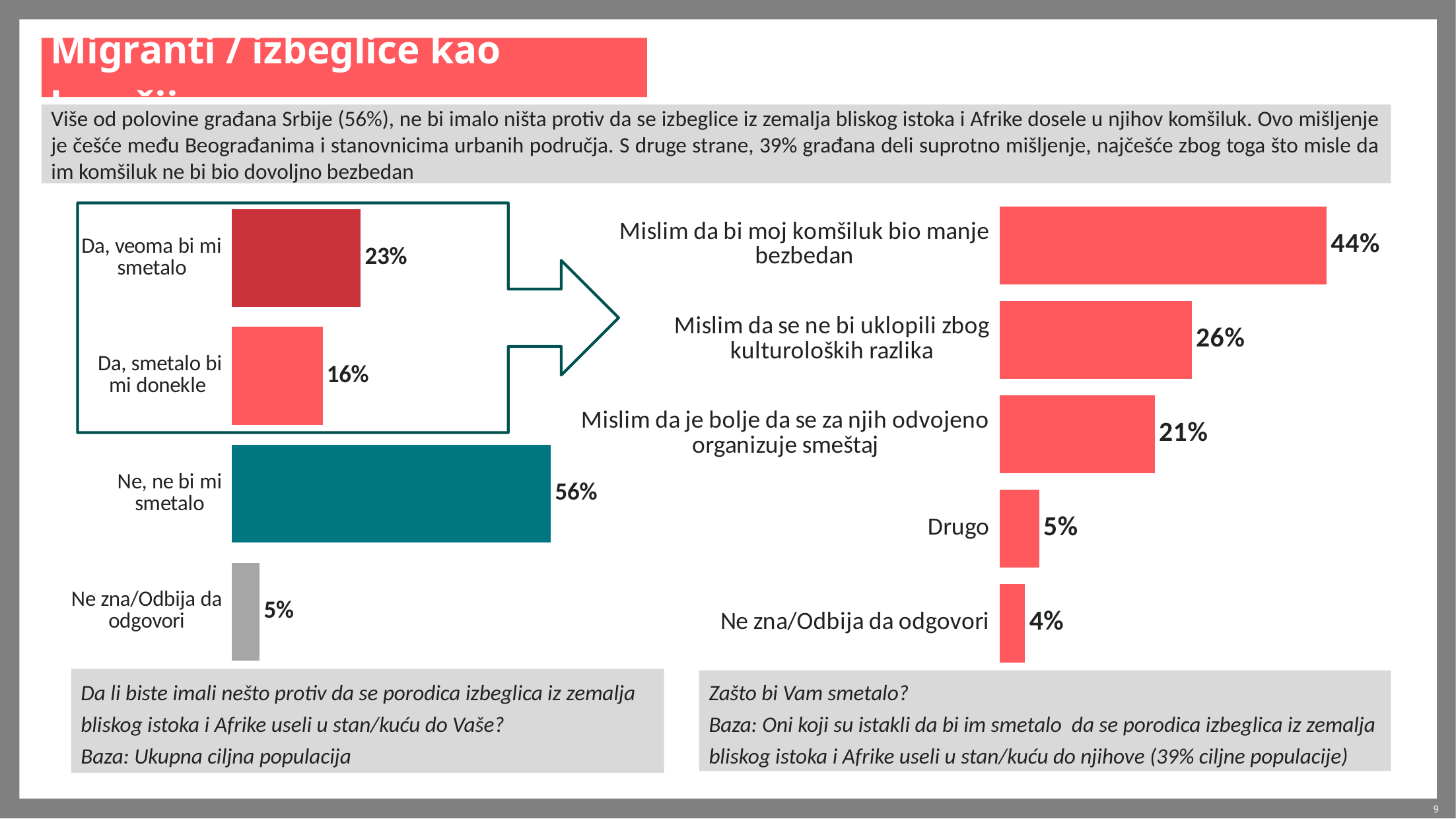
In the left chart, what is the difference between "Da, veoma bi mi smetalo" and "Da, smetalo bi mi donekle"? 7% In the left chart, what percentage of respondents answered "Ne, ne bi mi smetalo"? 56% In the right chart, which category has the lowest value? Ne zna/Odbija da odgovori In the right chart, what percentage chose "Mislim da je bolje da se za njih odvojeno organizuje smeštaj"? 21% What type of chart is the right chart? Bar chart In the left chart, how many categories are shown? 4 In the right chart, how many categories are shown? 5 In the left chart, what is the value for "Da, veoma bi mi smetalo"? 23% In the left chart, which category has the highest value? Ne, ne bi mi smetalo In the right chart, what is the value for "Mislim da bi moj komšiluk bio manje bezbedan"? 44% In the right chart, what is the difference between "Mislim da bi moj komšiluk bio manje bezbedan" and "Mislim da se ne bi uklopili zbog kulturoloških razlika"? 18% In the right chart, which is larger: "Mislim da se ne bi uklopili zbog kulturoloških razlika" or "Drugo"? Mislim da se ne bi uklopili zbog kulturoloških razlika